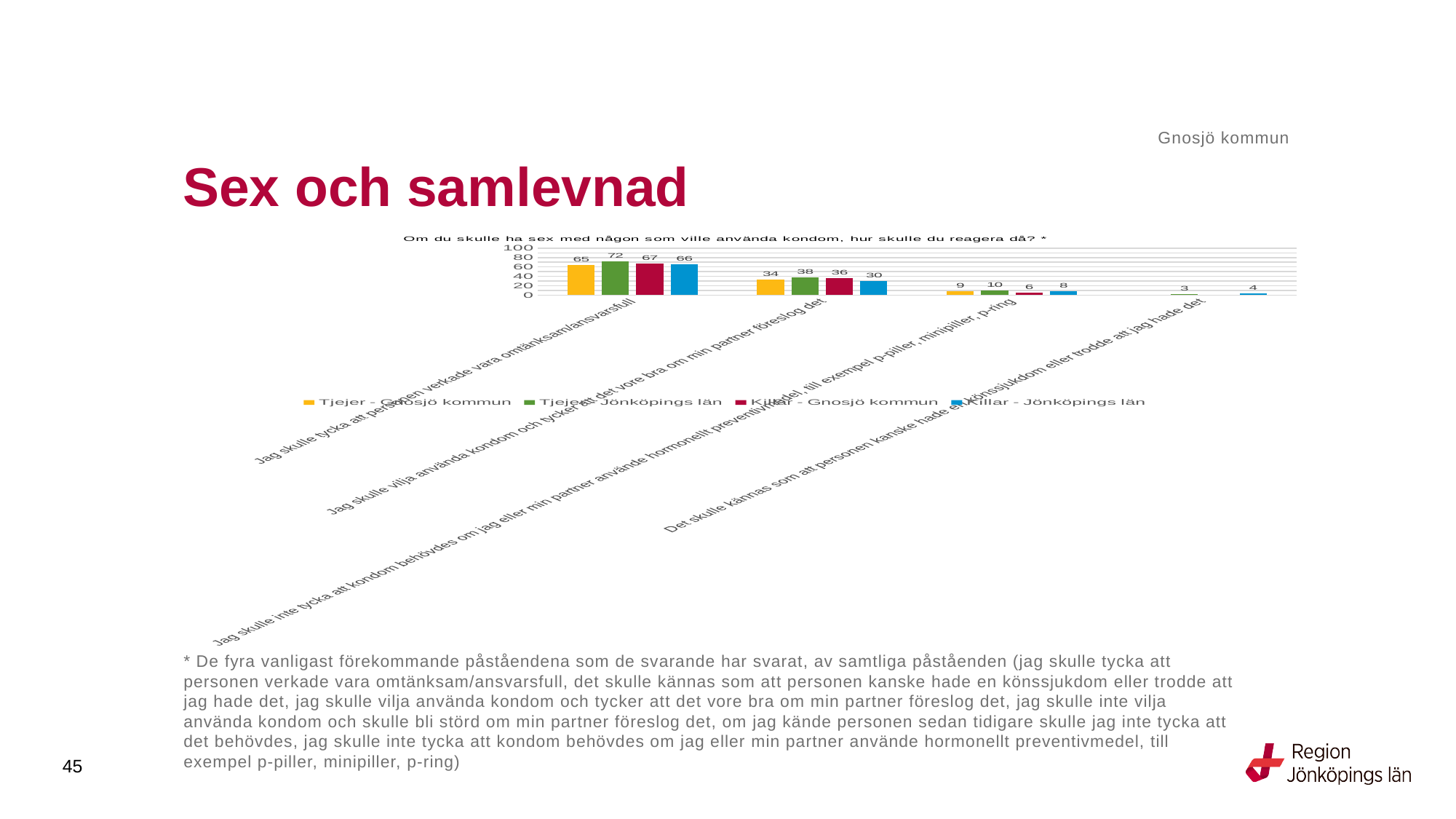
What is the difference between Tjejer - Jönköpings län and Tjejer - Gnosjö kommun in the category "Jag skulle tycka att personen verkade vara omtänksam/ansvarsfull"? 7 What kind of chart is shown on the slide? Bar chart Which is larger in the category "Jag skulle vilja använda kondom och tycker att det vore bra om min partner föreslog det": Tjejer - Gnosjö kommun or Killar - Gnosjö kommun? Killar - Gnosjö kommun Which colour represents Killar - Gnosjö kommun in the chart? Red Which series has the lowest value in the category "Jag skulle vilja använda kondom och tycker att det vore bra om min partner föreslog det"? Killar - Jönköpings län Do the values for Tjejer - Gnosjö kommun rise or fall across the first three categories from left to right? Fall What is the value for Killar - Jönköpings län in the category "Jag skulle vilja använda kondom och tycker att det vore bra om min partner föreslog det"? 30 How many series does the legend list? 4 What is the value for Tjejer - Jönköpings län in the category "Jag skulle tycka att personen verkade vara omtänksam/ansvarsfull"? 72 Which series has the highest value in the category "Jag skulle tycka att personen verkade vara omtänksam/ansvarsfull"? Tjejer - Jönköpings län Is the value for Killar - Gnosjö kommun in the category "Jag skulle tycka att personen verkade vara omtänksam/ansvarsfull" greater or less than 60? greater What is the value for Killar - Gnosjö kommun in the category about not thinking a condom is needed if hormonal contraception is used? 6